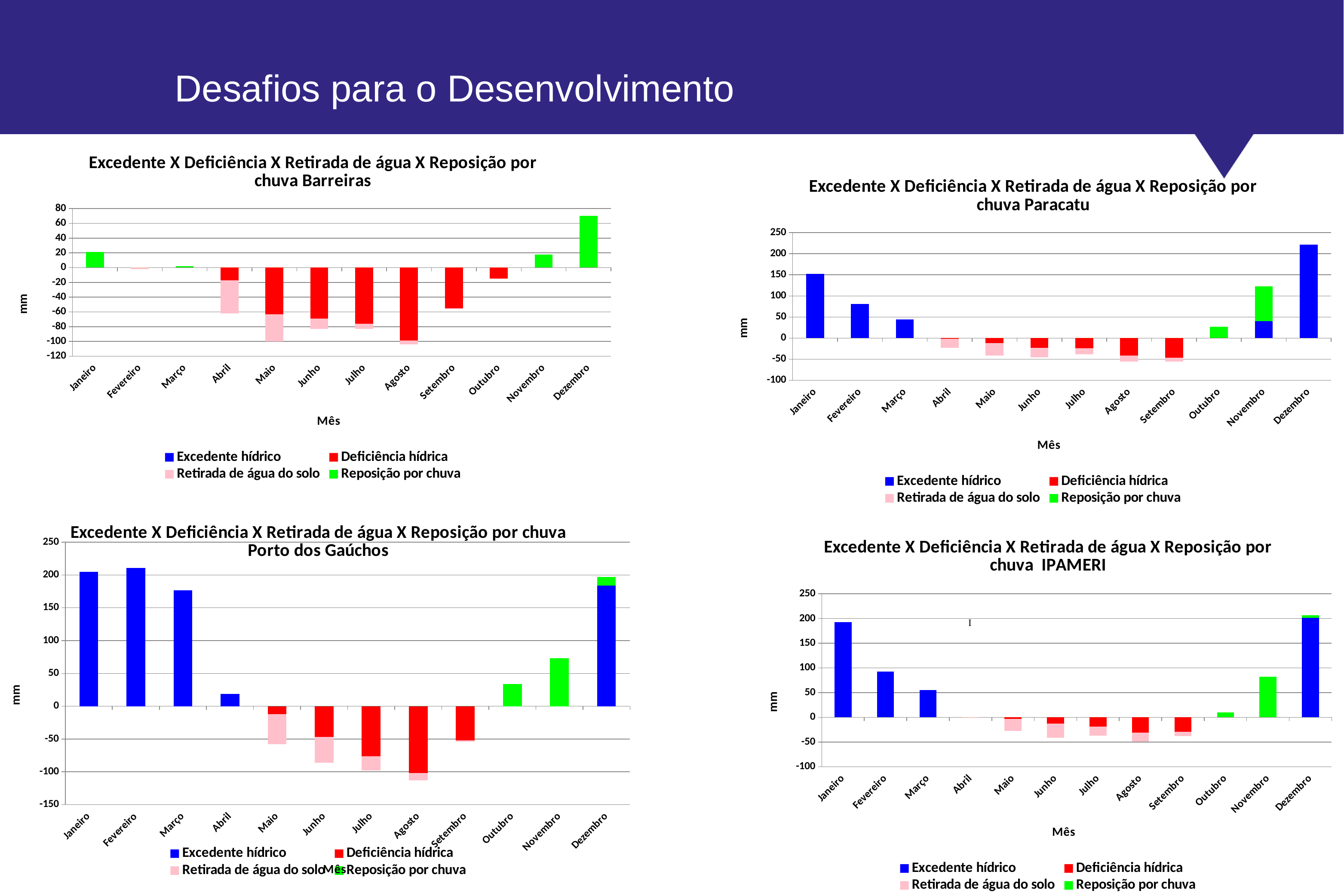
In the Paracatu chart, which month has the highest Excedente hídrico (blue) bar? Dezembro In the Barreiras chart, what kind of chart is used? bar chart In the Porto dos Gaúchos chart, which month has the largest Deficiência hídrica (red) bar? Agosto How many charts are shown on the slide? 4 In the Porto dos Gaúchos chart, is the Reposição por chuva value for Novembro greater or less than 50? greater In the Paracatu chart, is the Excedente hídrico value for Dezembro greater or less than 200? greater In the Barreiras chart, how many months are shown on the x axis? 12 In the IPAMERI chart, is the Excedente hídrico value for Fevereiro greater or less than 100? less In the Barreiras chart, which month has the tallest Reposição por chuva (green) bar? Dezembro In the Paracatu chart, how many series does the legend list? 4 In the IPAMERI chart, what is the label of the y axis? mm